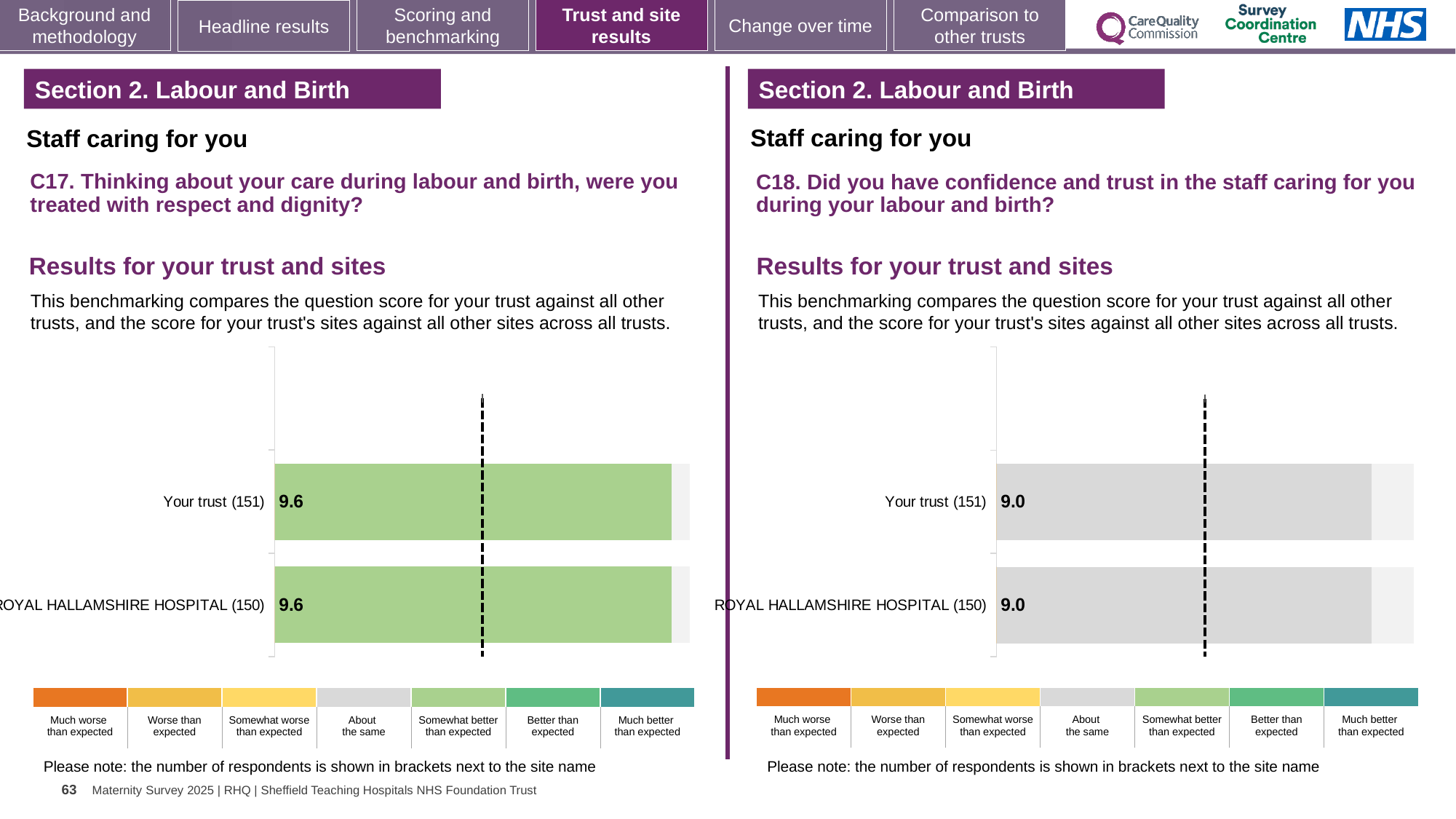
How many bars are plotted in the C17 chart on the left? 2 In the C17 chart on the left, what is the difference between the score for Your trust and the score for ROYAL HALLAMSHIRE HOSPITAL? 0.0 In the C17 chart on the left, what is the score for Your trust (151)? 9.6 How many respondents are shown in brackets for ROYAL HALLAMSHIRE HOSPITAL in the C18 chart on the right? 150 In the C17 chart on the left, which benchmark category does the colour of the bars correspond to according to the legend? Somewhat better than expected What type of chart is used for the C17 results on the left? Bar chart In the C18 chart on the right, what is the score for ROYAL HALLAMSHIRE HOSPITAL (150)? 9.0 In the C18 chart on the right, which benchmark category does the colour of the bars correspond to according to the legend? About the same How many bars are plotted in the C18 chart on the right? 2 In the C17 chart on the left, what is the score for ROYAL HALLAMSHIRE HOSPITAL (150)? 9.6 In the C18 chart on the right, what is the score for Your trust (151)? 9.0 In the C18 chart on the right, what is the difference between the score for Your trust and the score for ROYAL HALLAMSHIRE HOSPITAL? 0.0